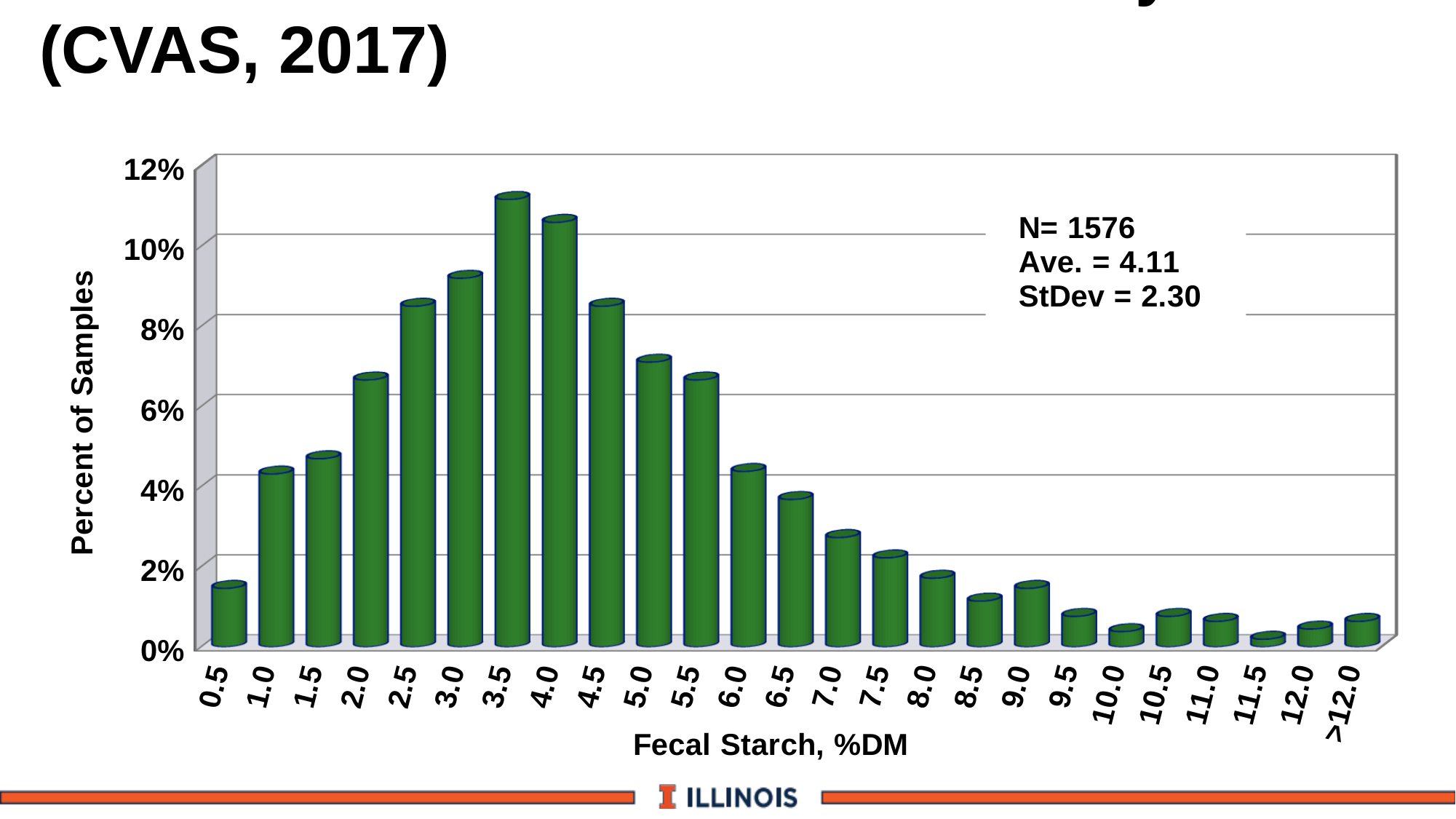
What sample size N is stated on the chart? 1576 What kind of chart is shown on the slide? bar chart Is the percent of samples for the 0.5 category greater or less than 2%? less Do the percent of samples values rise or fall from the 3.5 category to the 12.0 category? fall Which fecal starch category has the highest percent of samples? 3.5 How many fecal starch categories are shown on the x axis? 25 Which has a higher percent of samples, the 5.0 category or the 6.5 category? 5.0 Is the percent of samples for the 3.5 category greater or less than 10%? greater What is the x-axis title of the chart? Fecal Starch, %DM Is the percent of samples for the 7.0 category greater or less than 4%? less Which fecal starch category has the lowest percent of samples? 11.5